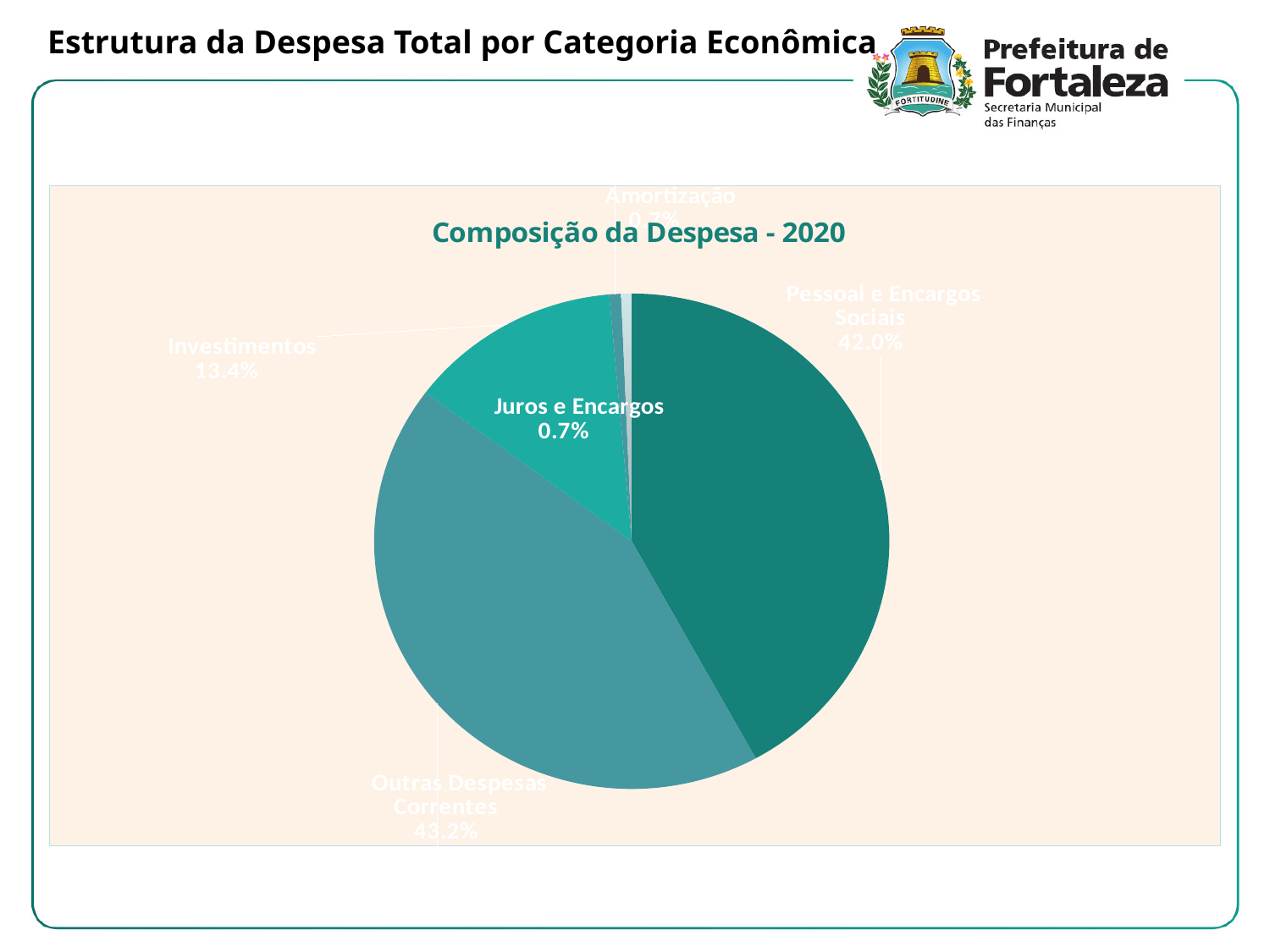
What is the difference between the shares of Outras Despesas Correntes and Pessoal e Encargos Sociais? 1.2% What share of the pie does Juros e Encargos represent? 0.7% What share of the pie does Investimentos represent? 13.4% Which category has the largest slice of the pie? Outras Despesas Correntes How many slices does the pie chart have? 5 Which is larger, Pessoal e Encargos Sociais or Investimentos? Pessoal e Encargos Sociais What share of the pie does Pessoal e Encargos Sociais represent? 42.0% What kind of chart is shown on the slide? Pie chart What is the title of the chart? Composição da Despesa - 2020 What is the difference between the shares of Pessoal e Encargos Sociais and Investimentos? 28.6% What share of the pie does Outras Despesas Correntes represent? 43.2% What is the combined share of Pessoal e Encargos Sociais and Outras Despesas Correntes? 85.2%